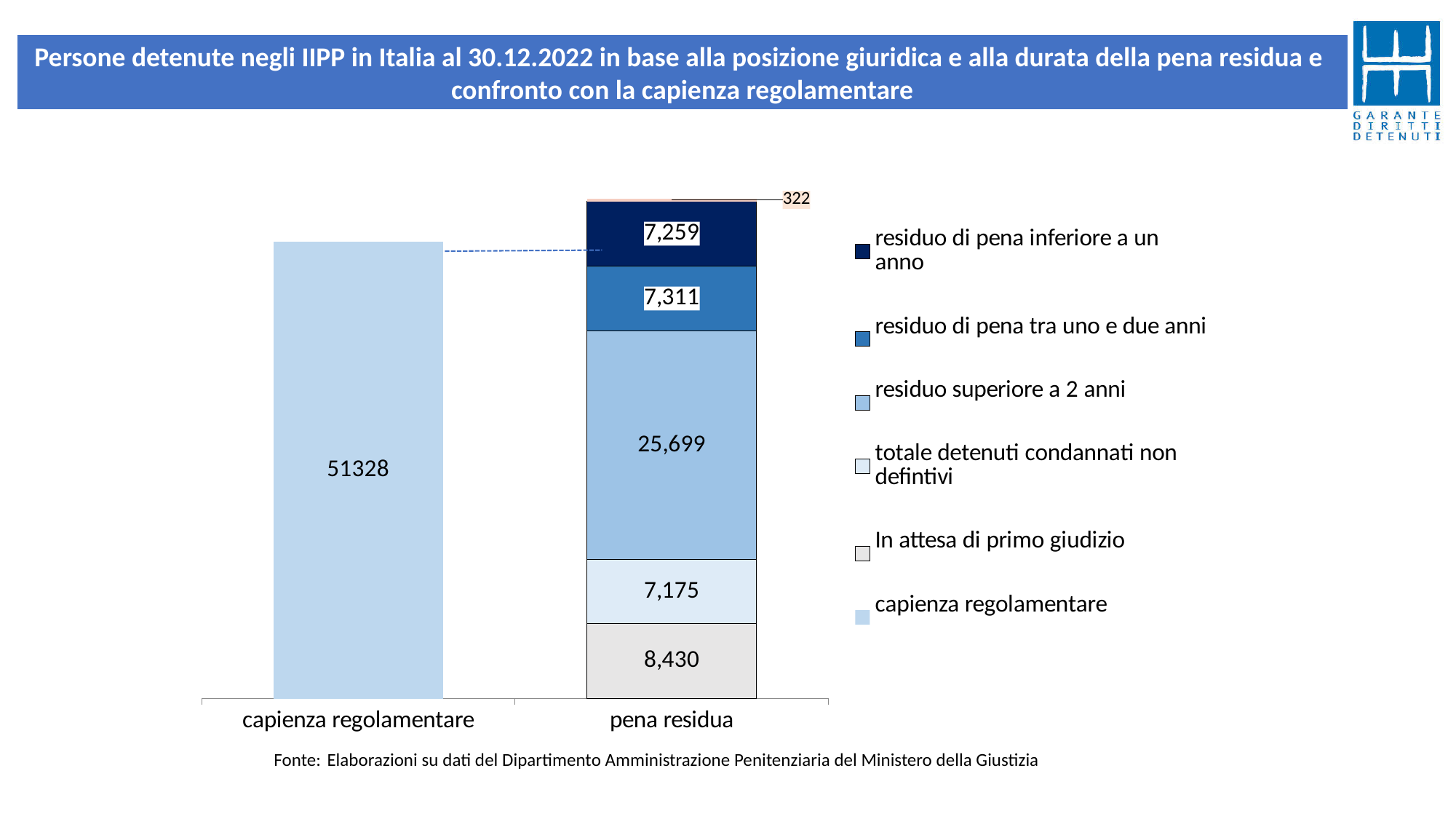
In the 'pena residua' bar, what is the value for 'residuo di pena inferiore a un anno'? 7,259 In the 'pena residua' bar, what is the value for 'residuo di pena tra uno e due anni'? 7,311 How many categories are shown on the x axis? 2 In the 'pena residua' bar, what is the value for 'residuo superiore a 2 anni'? 25,699 Which is larger: 'In attesa di primo giudizio' or 'totale detenuti condannati non defintivi'? In attesa di primo giudizio In the 'pena residua' bar, what is the value for 'In attesa di primo giudizio'? 8,430 What is the difference between 'residuo superiore a 2 anni' (25,699) and 'residuo di pena tra uno e due anni' (7,311)? 18,388 What kind of chart is shown on the slide? stacked bar chart What is the value shown for 'capienza regolamentare'? 51328 In the 'pena residua' bar, what is the value for 'totale detenuti condannati non defintivi'? 7,175 Which segment of the 'pena residua' bar has the largest value? residuo superiore a 2 anni How many entries does the legend list? 6